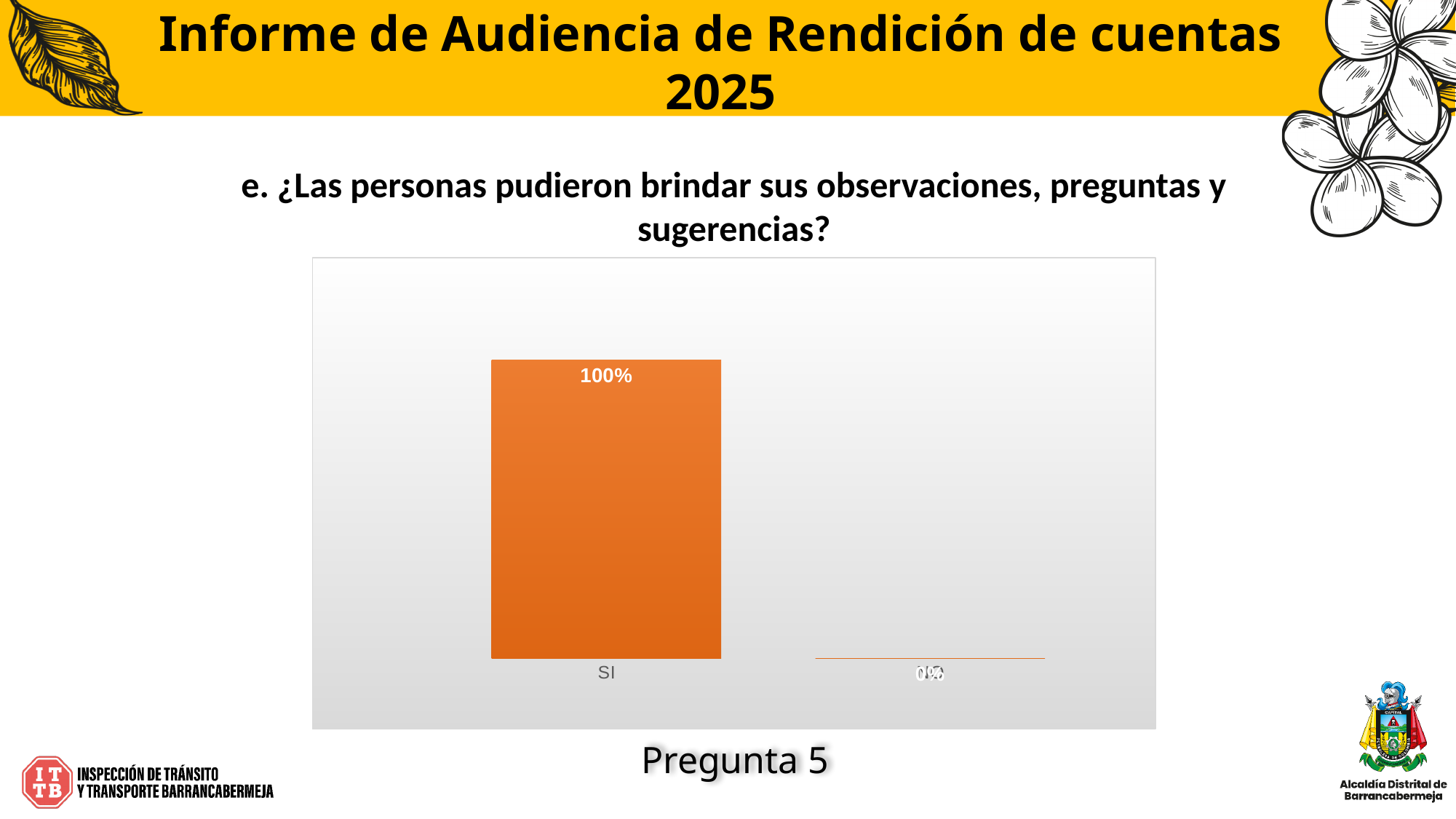
What question does the chart on the slide answer? e. ¿Las personas pudieron brindar sus observaciones, preguntas y sugerencias? What colour is the SI bar? Orange What is the value shown for the SI bar? 100% What kind of chart is shown on the slide? Bar chart How many categories are shown on the x axis of the chart? 2 Is the value for SI greater or less than 50%? greater Which category has the highest value in the chart? SI